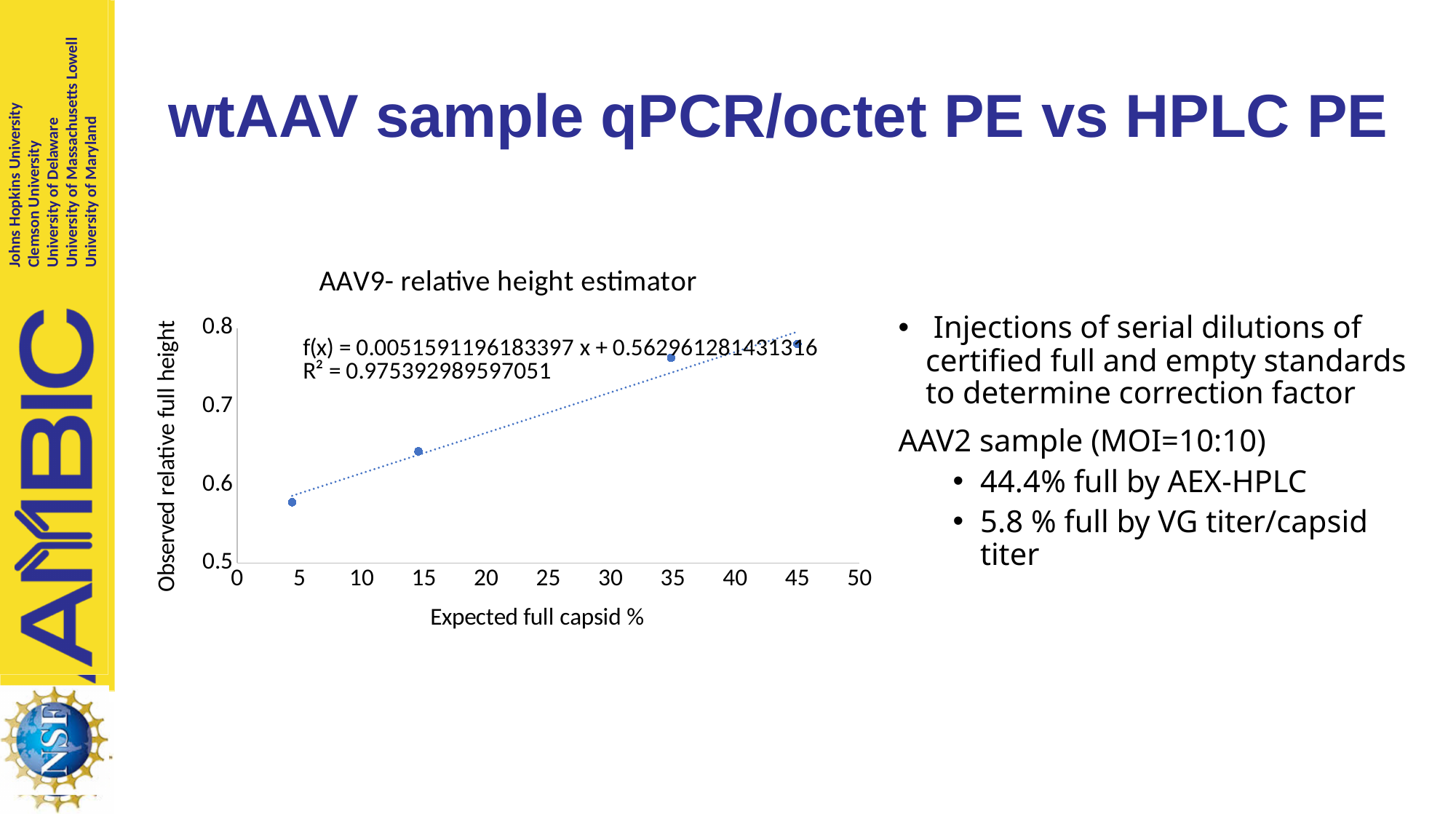
Is the observed relative full height for the data point near 35% expected full capsid greater or less than 0.7? greater What R² value is printed on the chart? 0.975392989597051 What is the slope of the fitted line printed on the chart? 0.0051591196183397 What kind of chart is shown on the slide? scatter plot What is the intercept of the fitted line printed on the chart? 0.562961281431316 Is the observed relative full height for the leftmost data point (near 5% expected full capsid) greater or less than 0.6? less Which data point has the lowest observed relative full height: the one near 5% or the one near 45% expected full capsid? the one near 5% How many data points are plotted on the chart? 4 Do the observed relative full height values rise or fall as expected full capsid % increases? rise Is the observed relative full height for the data point near 15% expected full capsid greater or less than 0.6? greater What is the title of the chart? AAV9- relative height estimator What is the label of the x axis of the chart? Expected full capsid %